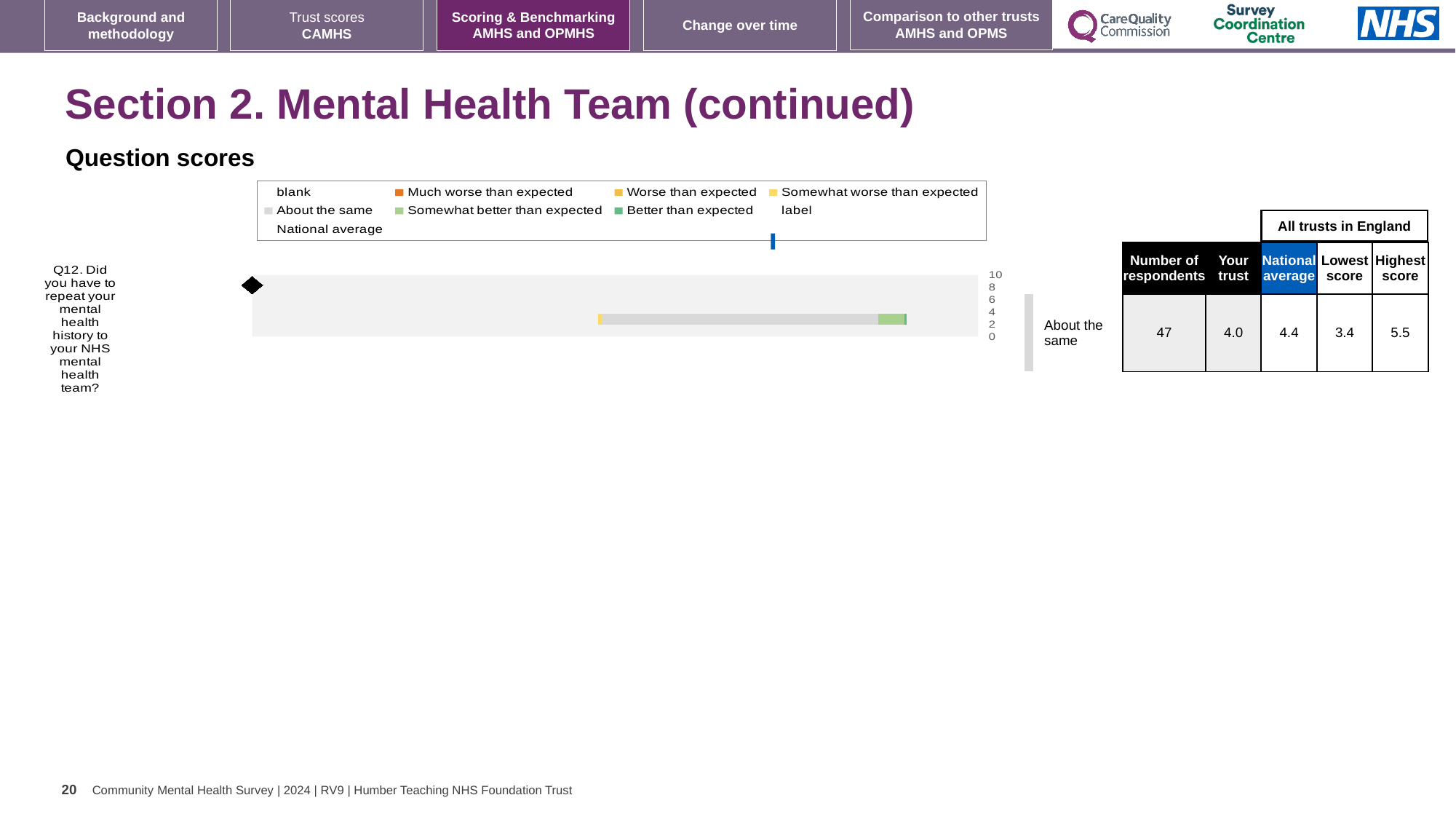
What benchmark category is shown next to the bar for Q12? About the same How many survey questions are plotted on the chart? 1 What is the highest score among all trusts in England for Q12? 5.5 What is the highest value shown on the chart's axis? 10 What is the lowest score among all trusts in England for Q12? 3.4 What is the difference between the highest score and the lowest score for Q12 across all trusts in England? 2.1 What kind of chart is used to show the Q12 question score? bar chart What is the national average score for Q12? 4.4 Which question is plotted on the chart? Q12. Did you have to repeat your mental health history to your NHS mental health team? How many respondents answered Q12? 47 What is the 'Your trust' score for Q12? 4.0 Is the trust's score for Q12 higher or lower than the national average? lower